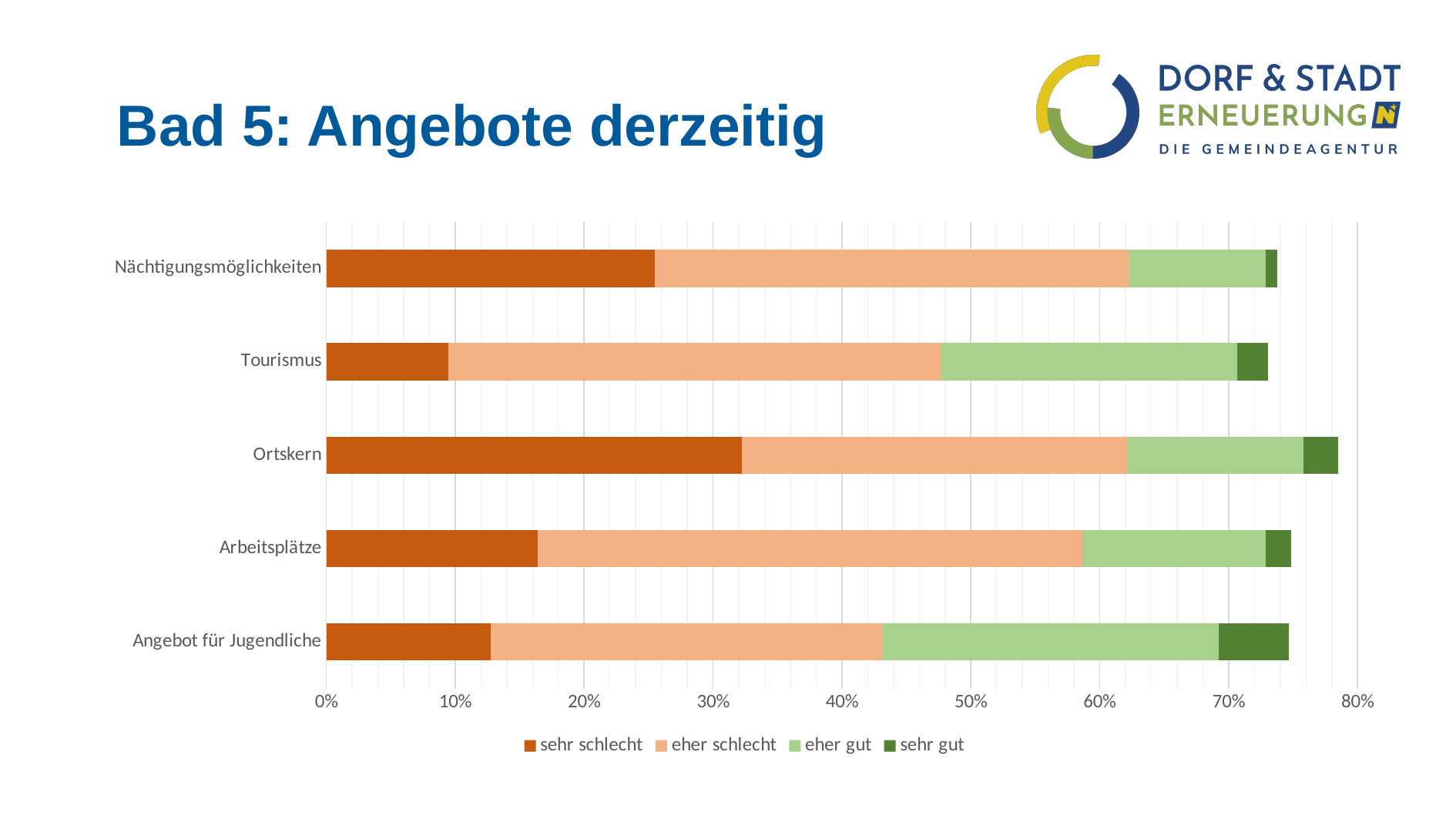
Which category has the longest total stacked bar? Ortskern Which legend entry is shown in the darkest green colour? sehr gut What is the title of the slide? Bad 5: Angebote derzeitig Is the 'sehr schlecht' value for Ortskern greater or less than 30%? greater Which category has the largest 'sehr schlecht' segment? Ortskern What kind of chart is shown on the slide? stacked bar chart How many series does the legend list? 4 Which category has the largest 'sehr gut' segment? Angebot für Jugendliche How many categories are plotted on the chart? 5 Which category has the smallest 'sehr schlecht' segment? Tourismus Which is larger: the 'sehr schlecht' segment for Ortskern or for Arbeitsplätze? Ortskern